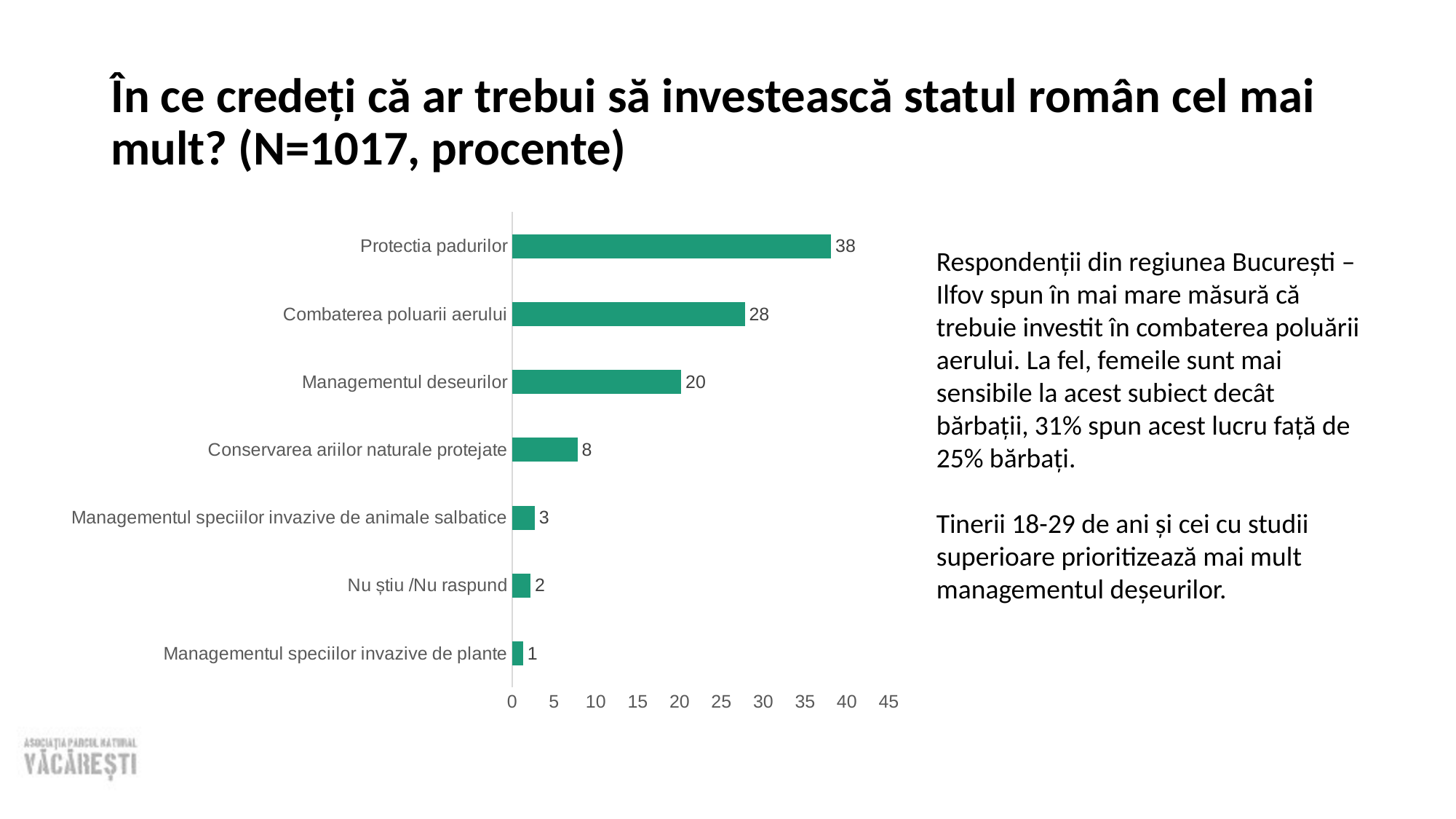
Which category has the lowest value? Managementul speciilor invazive de plante What is the value for Combaterea poluarii aerului? 28 What is the value for Nu știu /Nu raspund? 2 What is the value for Conservarea ariilor naturale protejate? 8 How many categories are shown in the chart? 7 Which is larger, the value for Managementul deseurilor or the value for Conservarea ariilor naturale protejate? Managementul deseurilor What kind of chart is shown on the slide? bar chart What is the value for Protectia padurilor? 38 What is the difference between the values for Protectia padurilor and Combaterea poluarii aerului? 10 What is the value for Managementul deseurilor? 20 Is the value for Combaterea poluarii aerului greater or less than 25? greater Which category has the highest value? Protectia padurilor